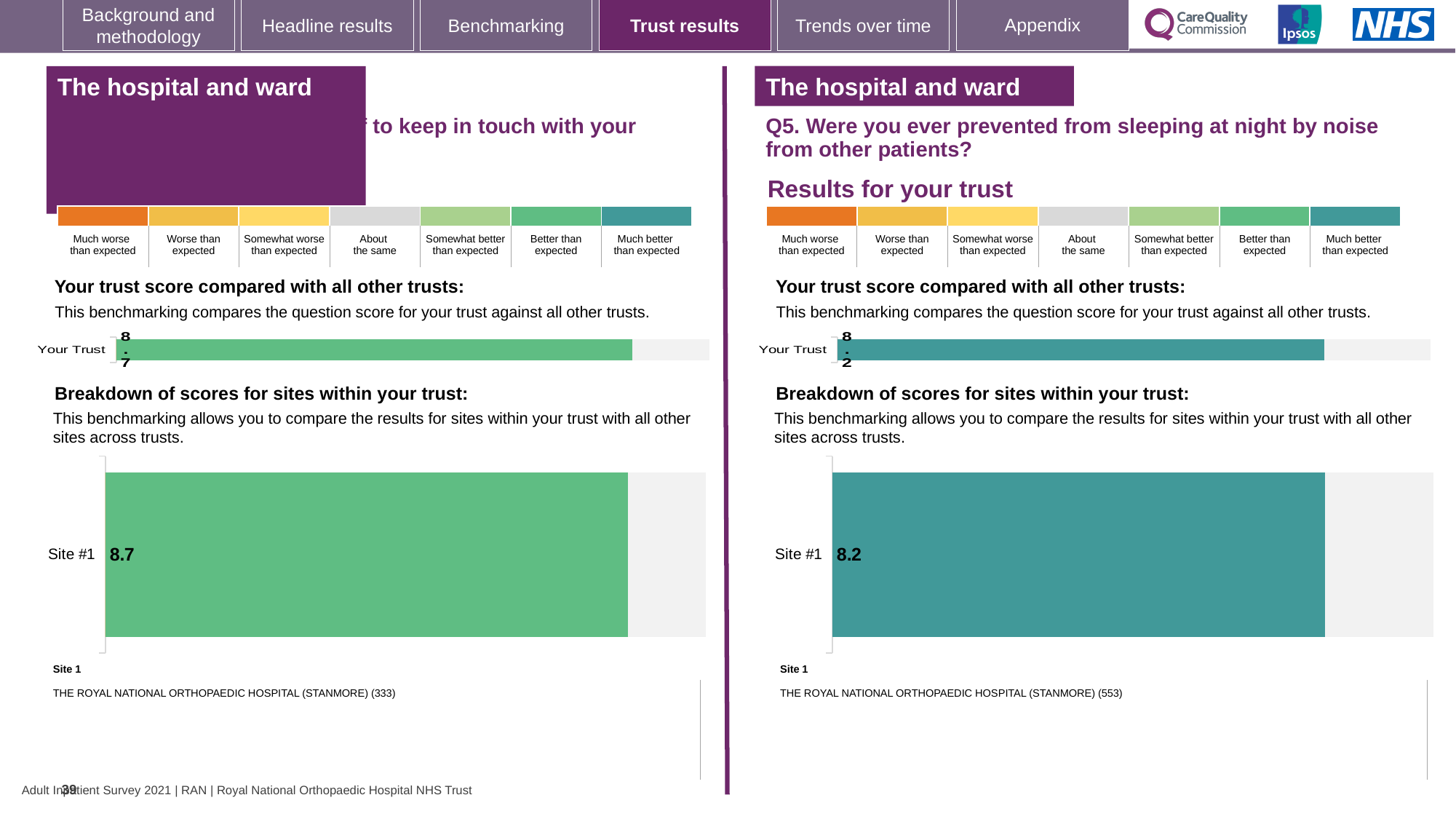
On the left-hand chart, what is the score shown for Site #1? 8.7 What kind of chart is used to show the breakdown of scores for sites within your trust on the right-hand side? Bar chart Which is larger: the Site #1 score on the left-hand chart or the Site #1 score on the right-hand Q5 chart? The left-hand chart (8.7) On the right-hand chart for Q5 (prevented from sleeping at night by noise from other patients), what is the score shown for Site #1? 8.2 Which site name is listed under Site 1 on the right-hand Q5 chart? THE ROYAL NATIONAL ORTHOPAEDIC HOSPITAL (STANMORE) (553) Which benchmark category does the colour of the Site #1 bar on the right-hand Q5 chart correspond to in the legend? Much better than expected How many sites are plotted in the 'Breakdown of scores for sites within your trust' chart on the right-hand Q5 side? 1 On the left-hand 'Your trust score compared with all other trusts' bar, what is the value shown for Your Trust? 8.7 On the right-hand 'Your trust score compared with all other trusts' bar for Q5, what is the value shown for Your Trust? 8.2 What is the difference between the Site #1 score on the left-hand chart (8.7) and the Site #1 score on the right-hand Q5 chart (8.2)? 0.5 How many sites are plotted in the 'Breakdown of scores for sites within your trust' chart on the left-hand side? 1